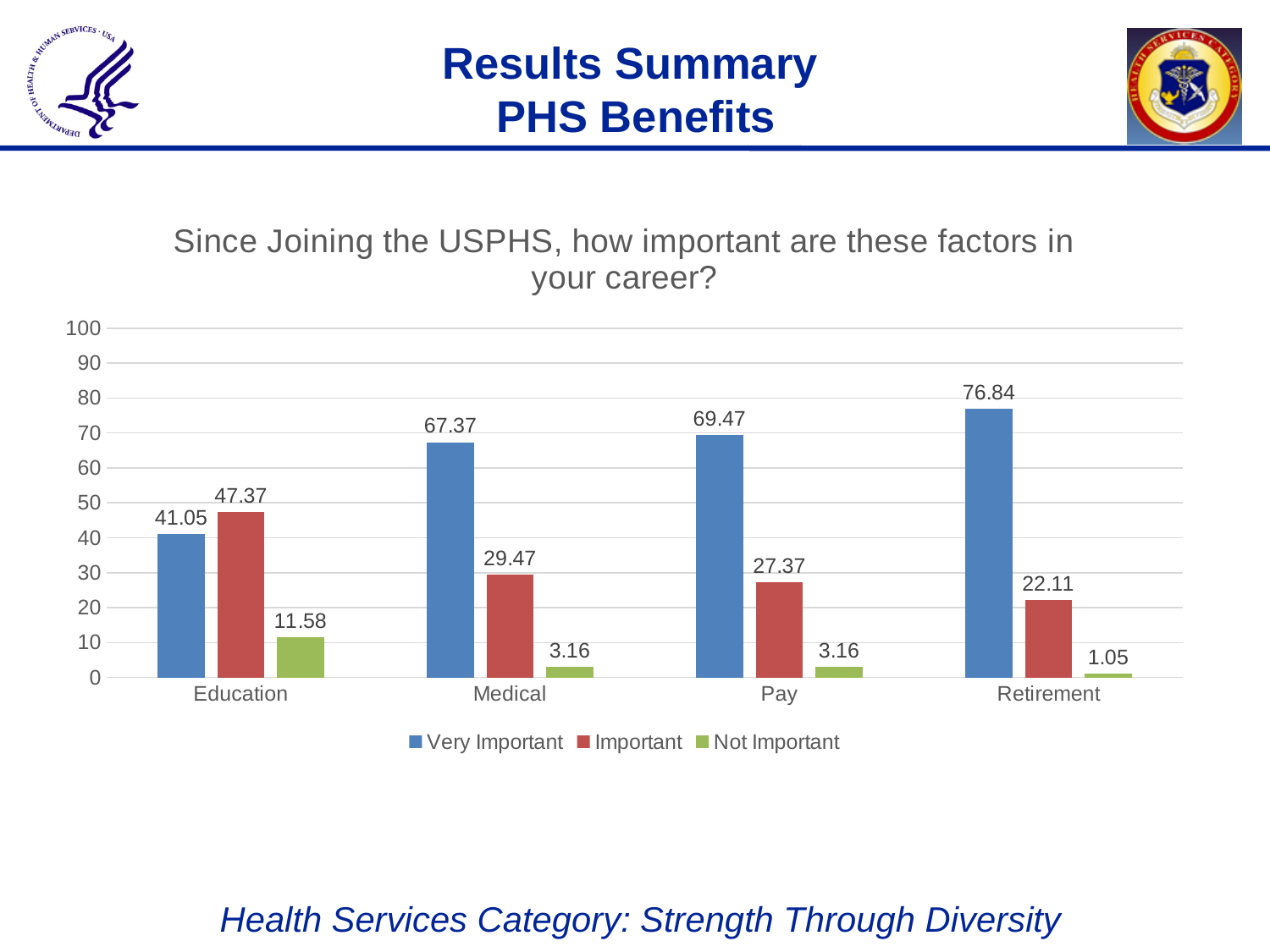
What is the 'Important' value for Education? 47.37 What is the title of the chart? Since Joining the USPHS, how important are these factors in your career? What kind of chart is shown on the slide? bar chart How many categories are shown on the x axis? 4 Is the 'Very Important' value for Pay greater or less than 60? greater What is the 'Very Important' value for Retirement? 76.84 How many series does the legend list? 3 What is the 'Not Important' value for Medical? 3.16 Which category has the highest 'Very Important' value? Retirement What is the difference between the 'Very Important' values for Retirement and Education? 35.79 Which is larger for Education: the 'Very Important' value or the 'Important' value? Important Which category has the lowest 'Not Important' value? Retirement